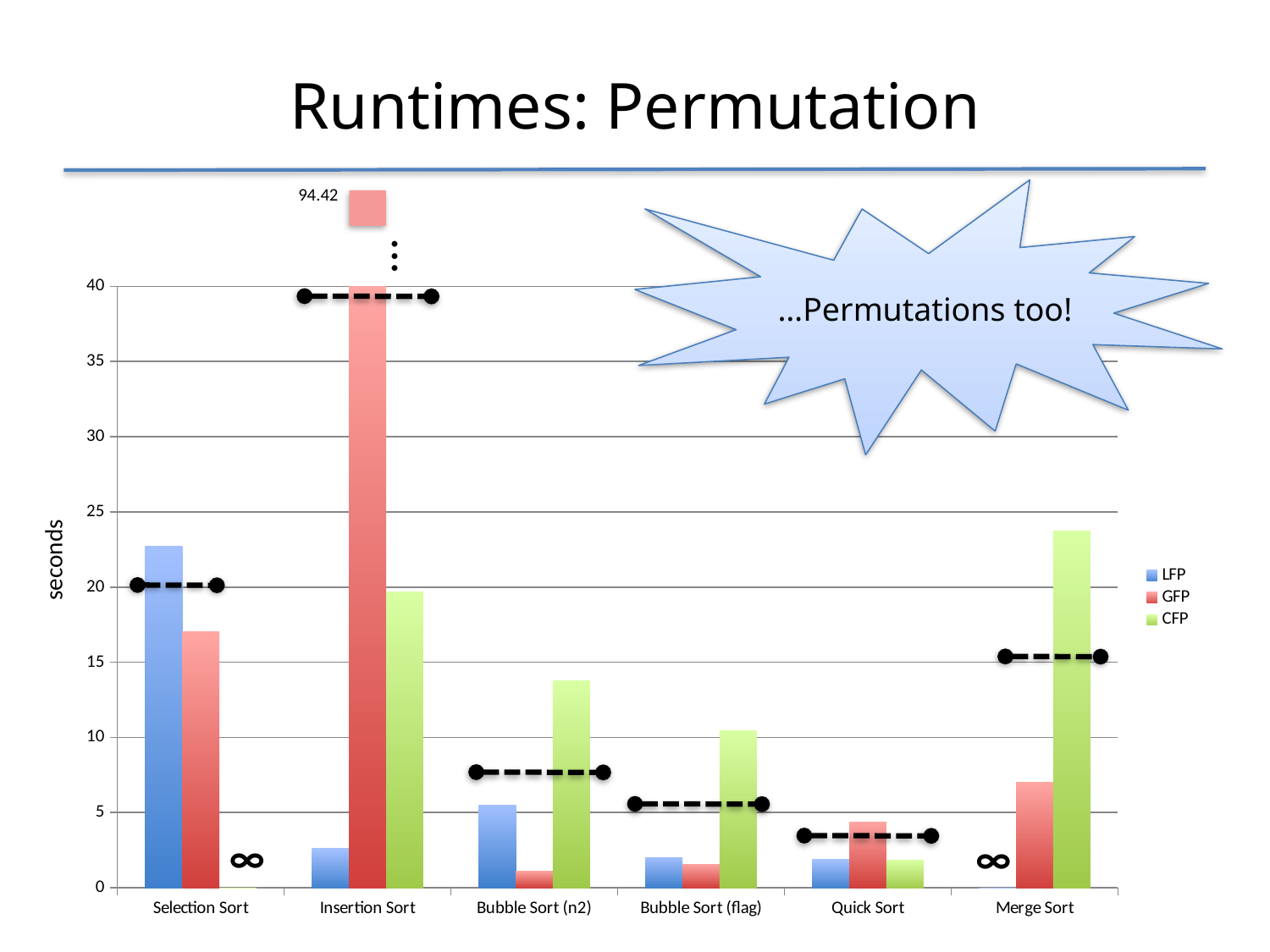
What kind of chart is shown on the slide? bar chart Which sorting algorithm has the highest GFP runtime? Insertion Sort Is the CFP value for Bubble Sort (n2) greater or less than 10? greater For Selection Sort, which is larger: the LFP bar or the GFP bar? LFP How many sorting algorithms (categories) are shown on the x axis? 6 How many series does the legend list? 3 Is the LFP value for Selection Sort greater or less than 20? greater For Bubble Sort (n2), which series has the lowest bar? GFP For Merge Sort, which is larger: the GFP bar or the CFP bar? CFP What is the GFP runtime for Insertion Sort, as labelled on the chart? 94.42 Is the LFP value for Quick Sort greater or less than 5? less What is the label on the y axis? seconds